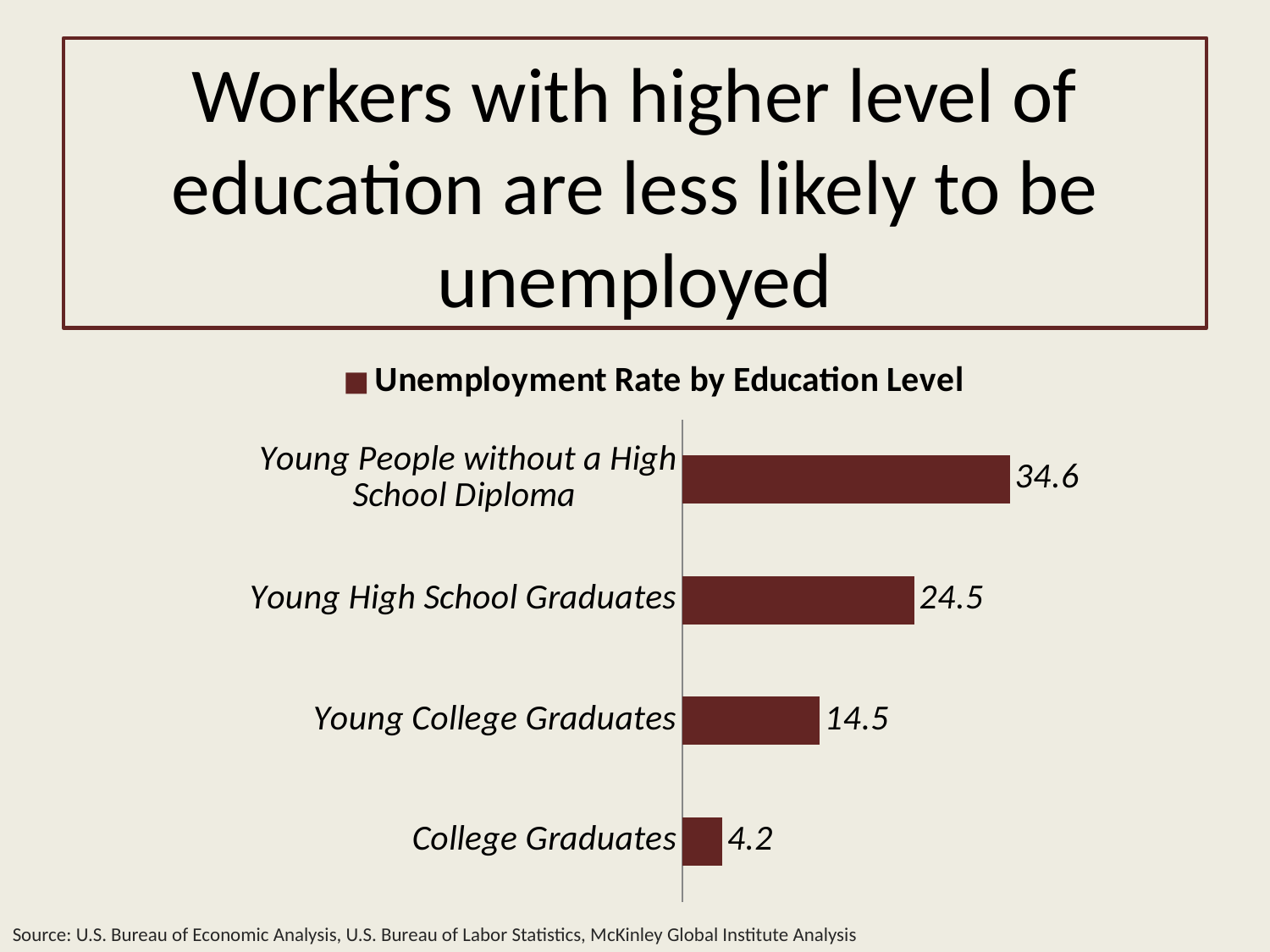
What is the unemployment rate for Young People without a High School Diploma? 34.6 What is the difference between the unemployment rates of Young People without a High School Diploma and College Graduates? 30.4 Which category has the highest unemployment rate? Young People without a High School Diploma Which category has the lowest unemployment rate? College Graduates What is the difference between the unemployment rates of Young High School Graduates and Young College Graduates? 10 What is the unemployment rate for Young College Graduates? 14.5 How many categories are shown in the chart? 4 What is the legend entry shown above the chart? Unemployment Rate by Education Level What kind of chart is shown on the slide? Bar chart Which has a higher unemployment rate, Young College Graduates or College Graduates? Young College Graduates What is the unemployment rate for College Graduates? 4.2 What is the unemployment rate for Young High School Graduates? 24.5